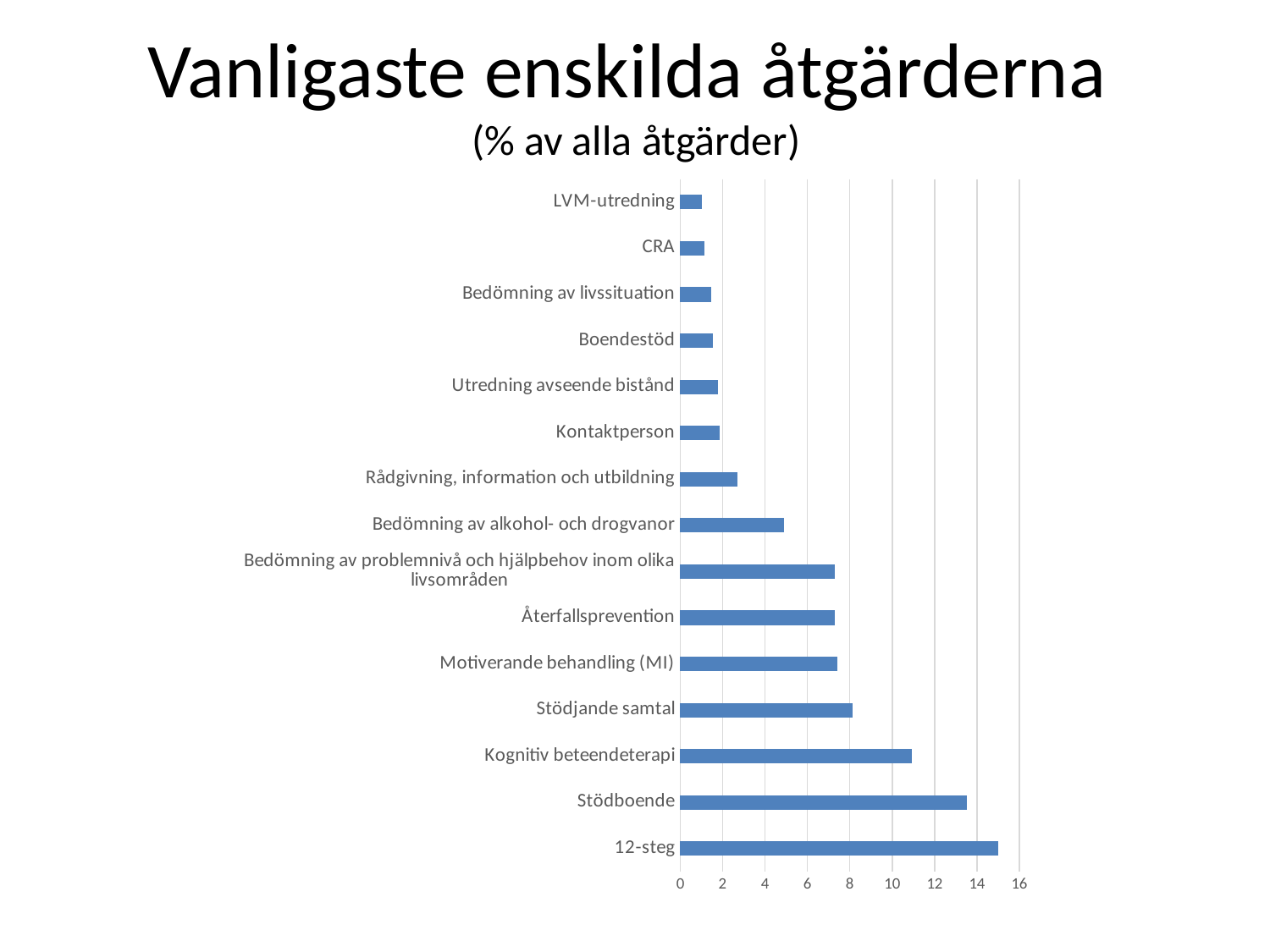
What is the title of the slide? Vanligaste enskilda åtgärderna Is the value for 12-steg greater or less than 14? greater Which åtgärd has the highest value in the chart? 12-steg Which has a larger value, Stödjande samtal or Motiverande behandling (MI)? Stödjande samtal What kind of chart is shown on the slide? bar chart Is the value for Bedömning av alkohol- och drogvanor greater or less than 6? less Is the value for Rådgivning, information och utbildning greater or less than 4? less What unit does the subtitle say the values are expressed in? % av alla åtgärder Which has a larger value, Stödboende or Kognitiv beteendeterapi? Stödboende How many categories (åtgärder) are plotted in the chart? 15